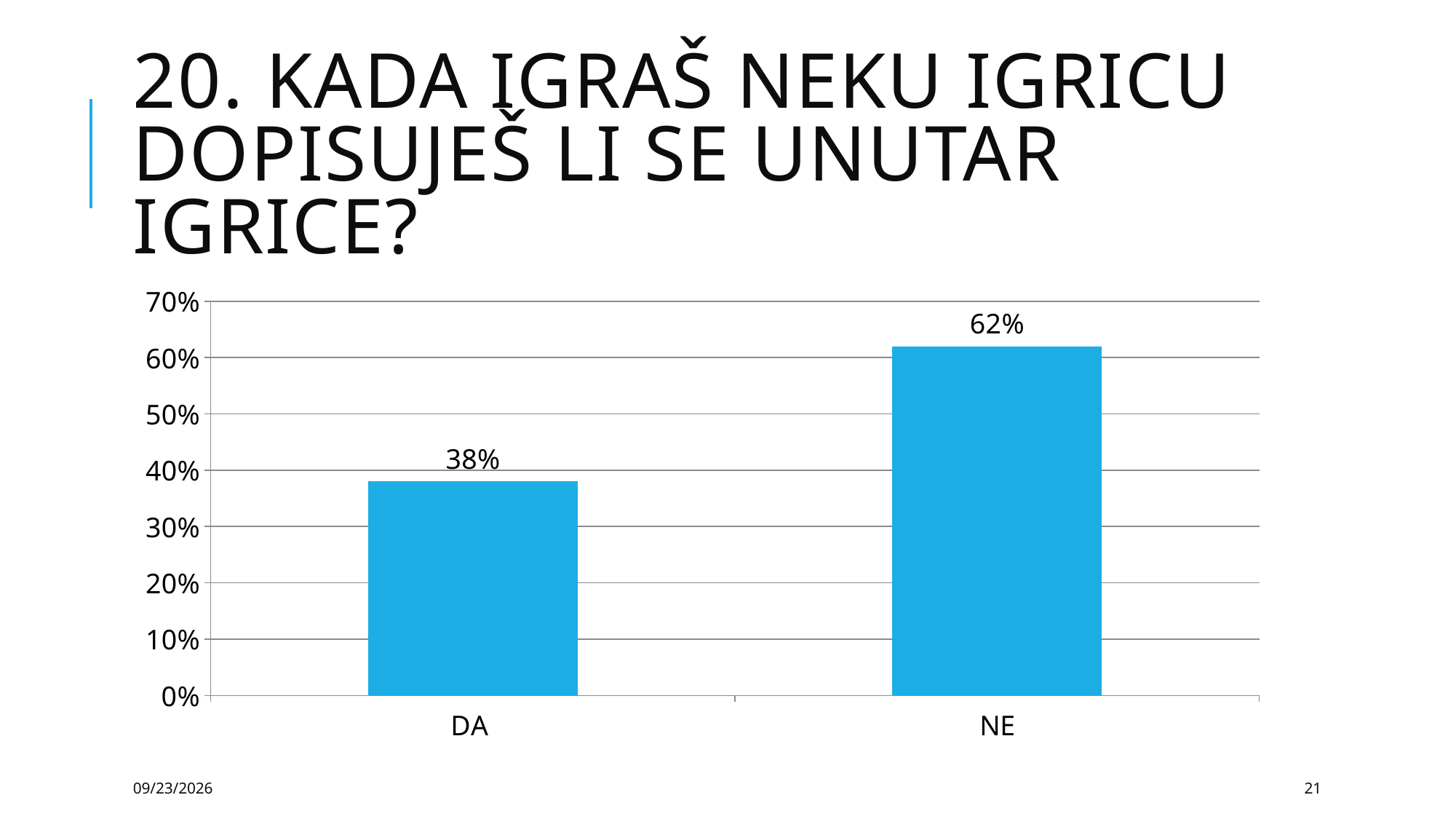
Which category has the lowest value? DA What is the value for NE? 62% How many categories are shown on the x axis? 2 Which category has the highest value? NE Is the value for DA greater or less than 40%? less What is the value for DA? 38% Which is larger, the value for DA or the value for NE? NE What is the highest value shown on the y axis? 70% What is the difference between the values for NE and DA? 24% What kind of chart is shown on the slide? bar chart What colour are the bars in the chart? blue Is the value for NE greater or less than 60%? greater